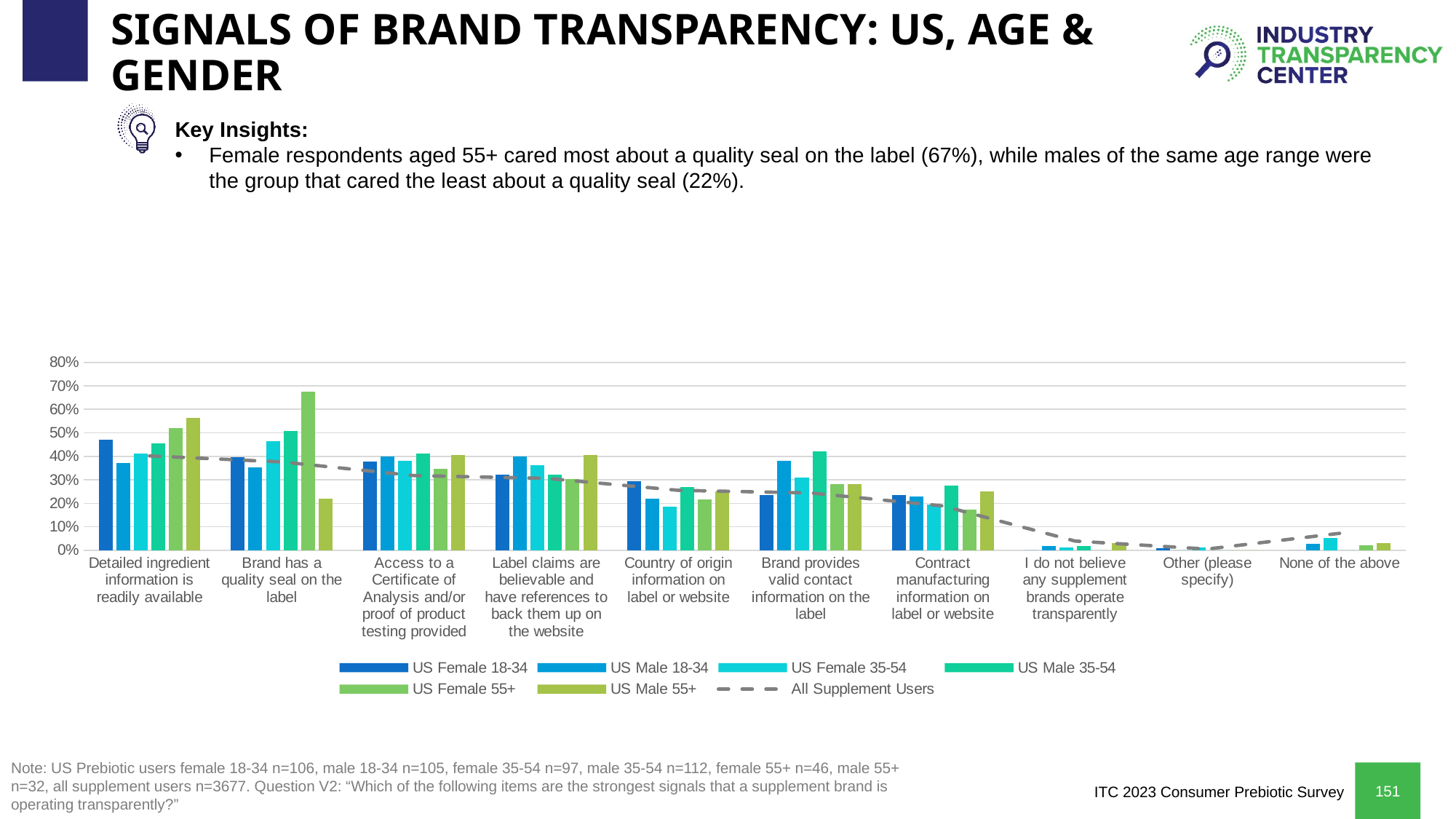
Which series is drawn as a dashed line rather than bars? All Supplement Users Which series has the lowest bar for 'Brand has a quality seal on the label'? US Male 55+ How many series does the chart legend list? 7 For 'Brand provides valid contact information on the label', which is larger: US Male 35-54 or US Female 35-54? US Male 35-54 What percentage of US Female 55+ respondents chose 'Brand has a quality seal on the label'? 67% Is the value for US Female 18-34 on 'Detailed ingredient information is readily available' greater or less than 40%? greater How many categories are shown along the x axis of the chart? 10 What percentage of US Male 55+ respondents chose 'Brand has a quality seal on the label'? 22% What type of chart is shown on the slide? combination bar and line chart Which series has the highest bar for 'Brand has a quality seal on the label'? US Female 55+ Is the value for US Male 55+ on 'Detailed ingredient information is readily available' greater or less than 50%? greater For 'Detailed ingredient information is readily available', which is larger: US Female 18-34 or US Male 18-34? US Female 18-34